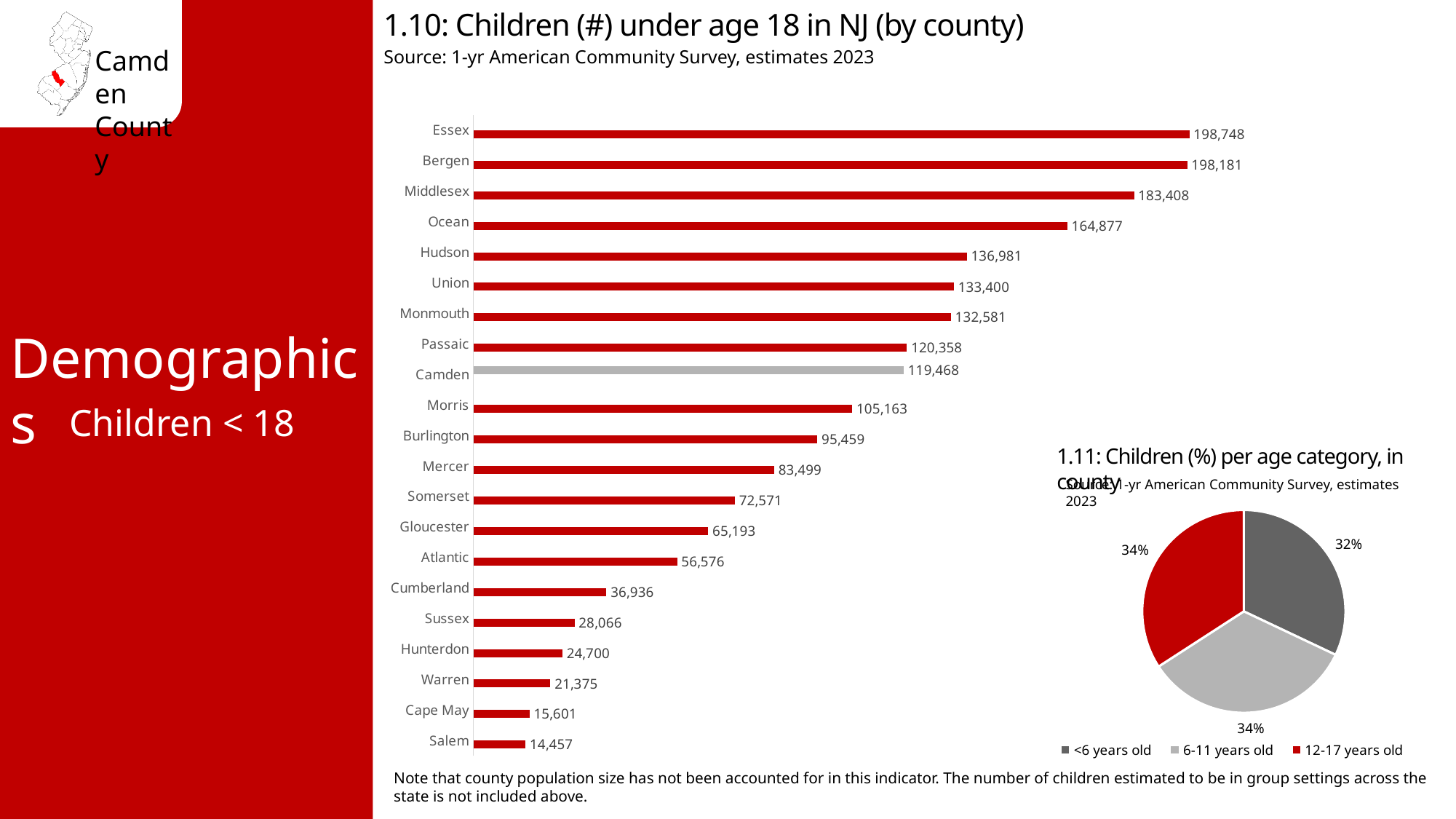
In the chart '1.10: Children (#) under age 18 in NJ (by county)', what is the value for Camden? 119,468 How many categories does the legend of the pie chart '1.11: Children (%) per age category, in county' list? 3 In the pie chart '1.11: Children (%) per age category, in county', what share is shown for the '<6 years old' category? 32% In the chart '1.10: Children (#) under age 18 in NJ (by county)', what is the value for Gloucester? 65,193 In the chart '1.10: Children (#) under age 18 in NJ (by county)', which has a larger value, Ocean or Hudson? Ocean In the chart '1.10: Children (#) under age 18 in NJ (by county)', what is the difference between the values for Essex and Bergen? 567 How many counties are shown in the chart '1.10: Children (#) under age 18 in NJ (by county)'? 21 In the chart '1.10: Children (#) under age 18 in NJ (by county)', which county has the highest value? Essex In the chart '1.10: Children (#) under age 18 in NJ (by county)', which county has the lowest value? Salem In the chart '1.10: Children (#) under age 18 in NJ (by county)', which county's bar is coloured grey instead of red? Camden What kind of chart is '1.11: Children (%) per age category, in county'? Pie chart What kind of chart is '1.10: Children (#) under age 18 in NJ (by county)'? Bar chart